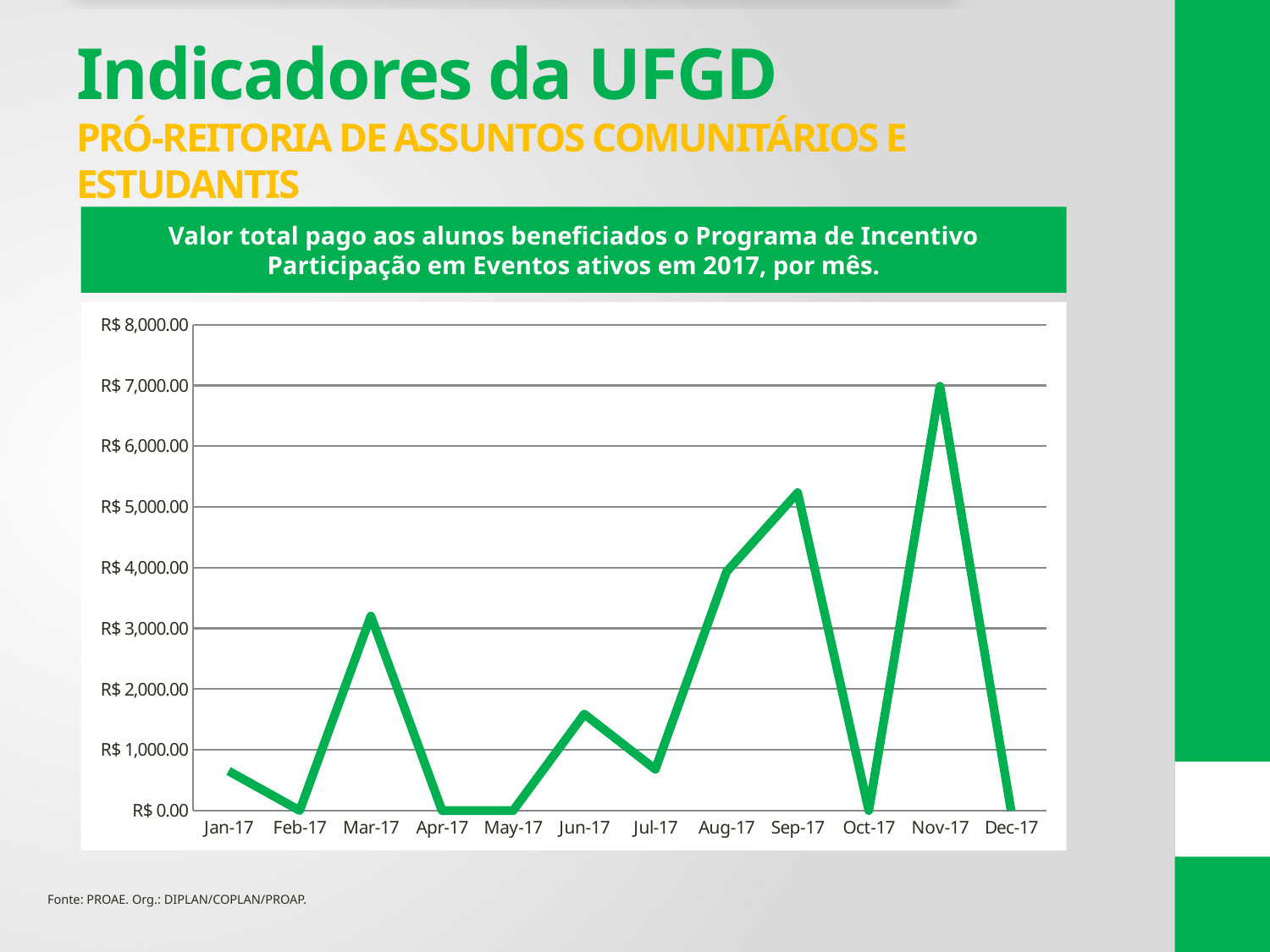
Is the value for Sep-17 greater or less than R$ 4,000.00? greater Is the value for Nov-17 greater or less than R$ 6,000.00? greater What kind of chart is shown on the slide? line chart Which month has the highest value in the chart? Nov-17 What is the value for Oct-17? R$ 0.00 Do the values rise or fall from Jul-17 to Sep-17? rise Is the value for Jan-17 greater or less than R$ 1,000.00? less Which is larger, the value for Aug-17 or the value for Jun-17? Aug-17 What is the value for Feb-17? R$ 0.00 How many months are plotted on the x axis of the chart? 12 What is the title of the chart? Valor total pago aos alunos beneficiados o Programa de Incentivo Participação em Eventos ativos em 2017, por mês.